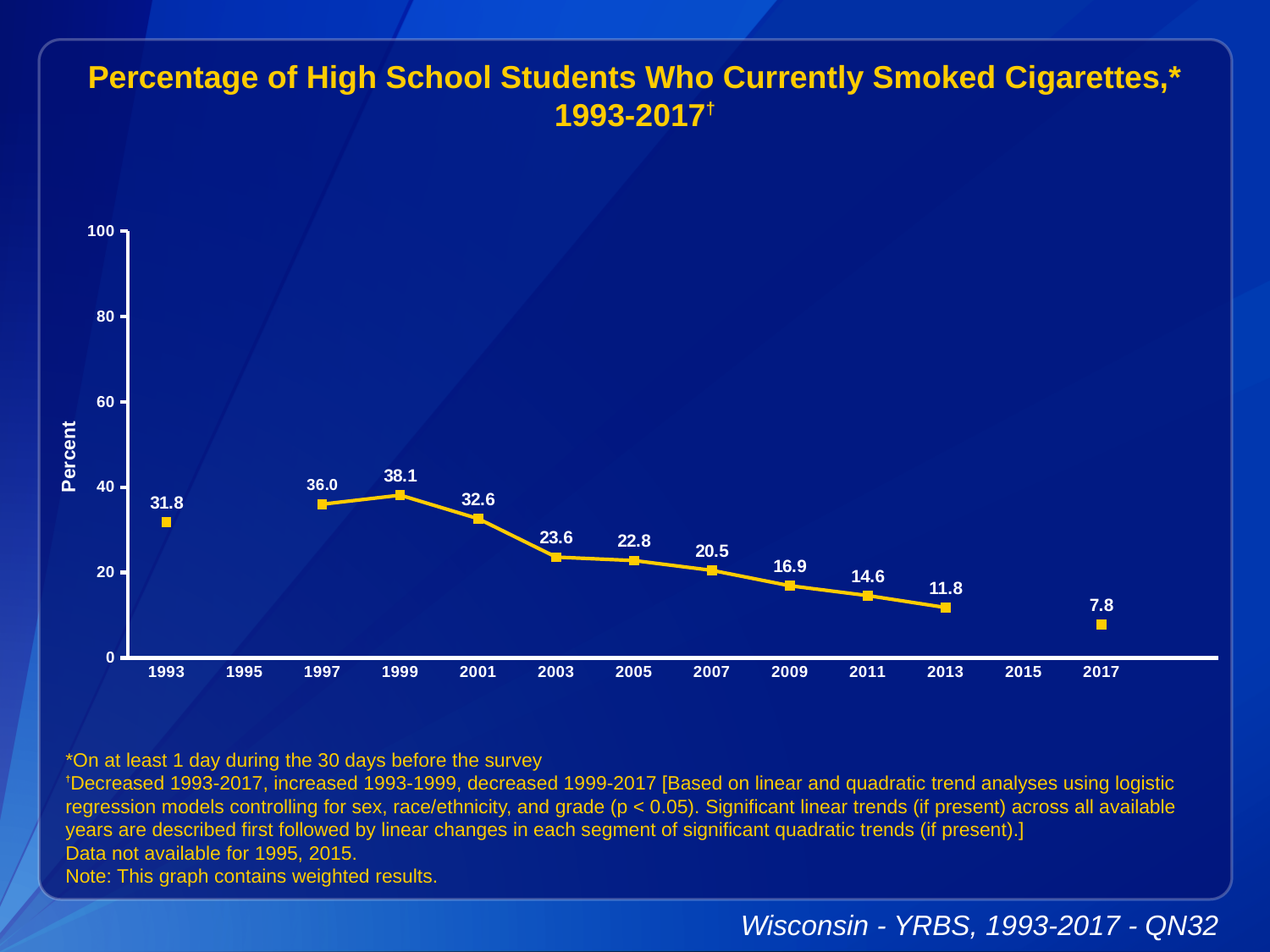
What is the difference between the 1993 value and the 2017 value? 24.0 What percentage of high school students currently smoked cigarettes in 1999? 38.1 Which year has the highest percentage of students who currently smoked cigarettes? 1999 What is the value plotted for 2007? 20.5 Do the values generally rise or fall from 1999 to 2017? fall What is the difference between the 1999 value and the 2001 value? 5.5 What kind of chart is shown on the slide? line chart How many years have data points plotted on the chart? 11 Is the value for 2011 greater or less than 20? less Which year has the lowest percentage of students who currently smoked cigarettes? 2017 What is the value plotted for 2017? 7.8 Which year has a larger value, 2003 or 2005? 2003